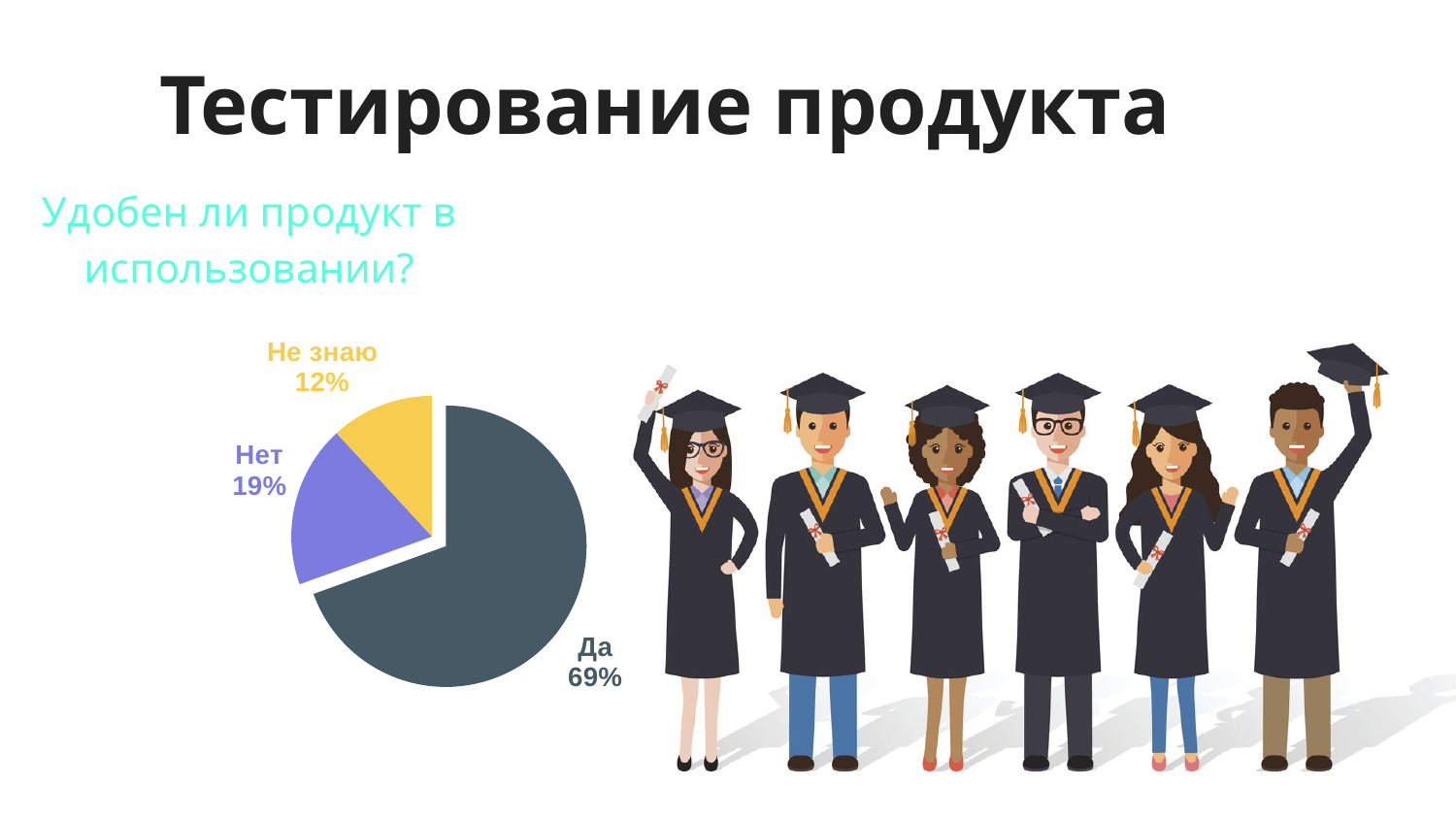
What question does the pie chart answer, according to the text above it? Удобен ли продукт в использовании? What percentage of respondents answered "Не знаю"? 12% What percentage of respondents answered "Да"? 69% Which is larger, the share for "Нет" or the share for "Не знаю"? Нет What is the difference in percentage points between "Да" and "Нет"? 50 What kind of chart is shown on the slide? pie chart Which answer has the smallest share of the pie? Не знаю Which answer has the largest share of the pie? Да What percentage of respondents answered "Нет"? 19% What colour is the "Не знаю" slice of the pie chart? yellow How many slices does the pie chart have? 3 What is the difference in percentage points between "Нет" and "Не знаю"? 7